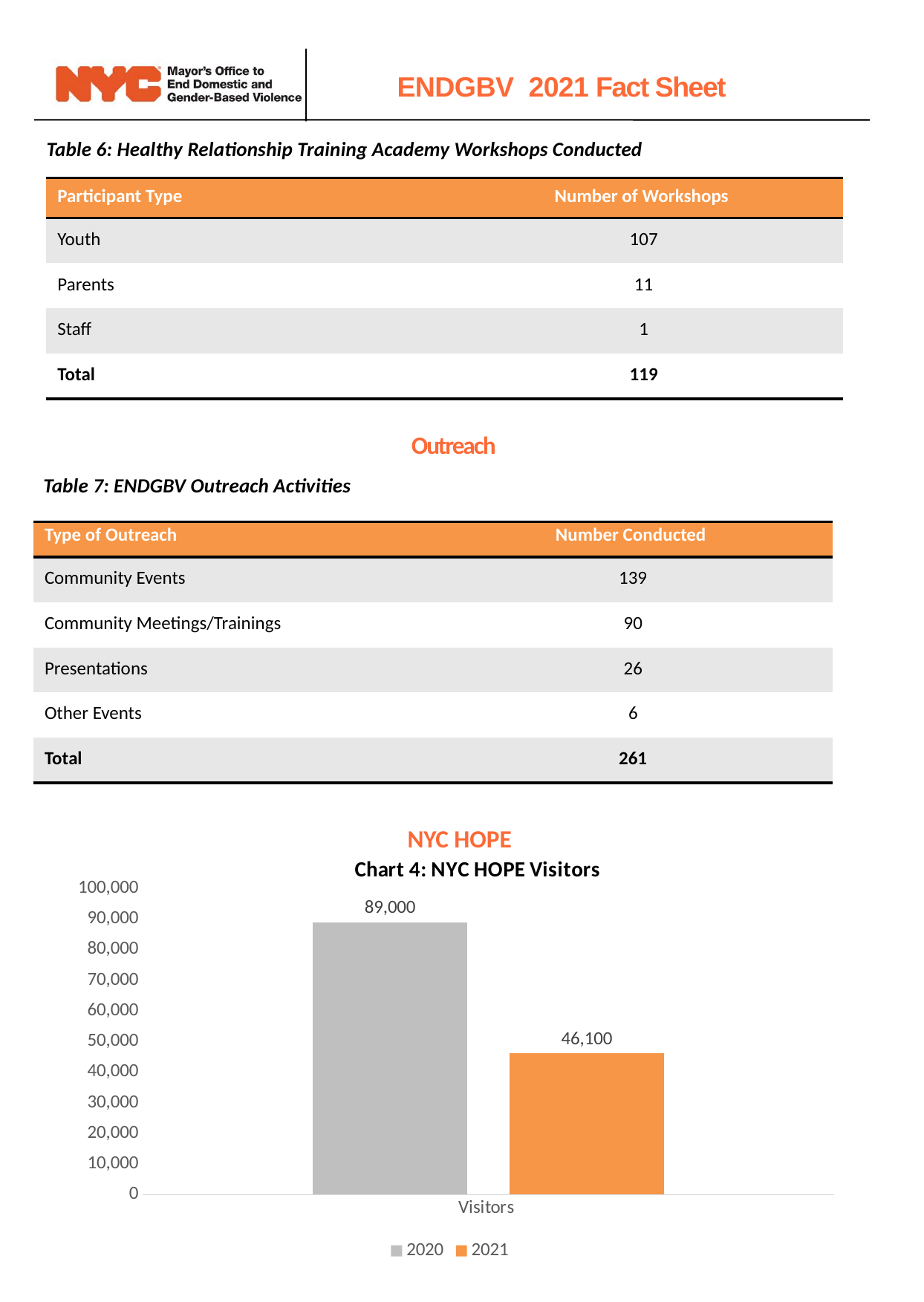
In Chart 4: NYC HOPE Visitors, is the value for 2021 greater or less than 50,000? less In Chart 4: NYC HOPE Visitors, which year has the higher number of visitors? 2020 In Chart 4: NYC HOPE Visitors, what colour is the bar for 2021? orange In Chart 4: NYC HOPE Visitors, did the number of visitors rise or fall from 2020 to 2021? fall In Chart 4: NYC HOPE Visitors, what is the value for 2021? 46,100 In Chart 4: NYC HOPE Visitors, what is the value for 2020? 89,000 What kind of chart is Chart 4: NYC HOPE Visitors? bar chart In Chart 4: NYC HOPE Visitors, is the 2021 value larger or smaller than the 2020 value? smaller How many series does the legend of Chart 4: NYC HOPE Visitors list? 2 In Chart 4: NYC HOPE Visitors, what is the difference between the 2020 and 2021 values? 42,900 In Chart 4: NYC HOPE Visitors, is the value for 2020 greater or less than 80,000? greater In Chart 4: NYC HOPE Visitors, which year has the lower number of visitors? 2021